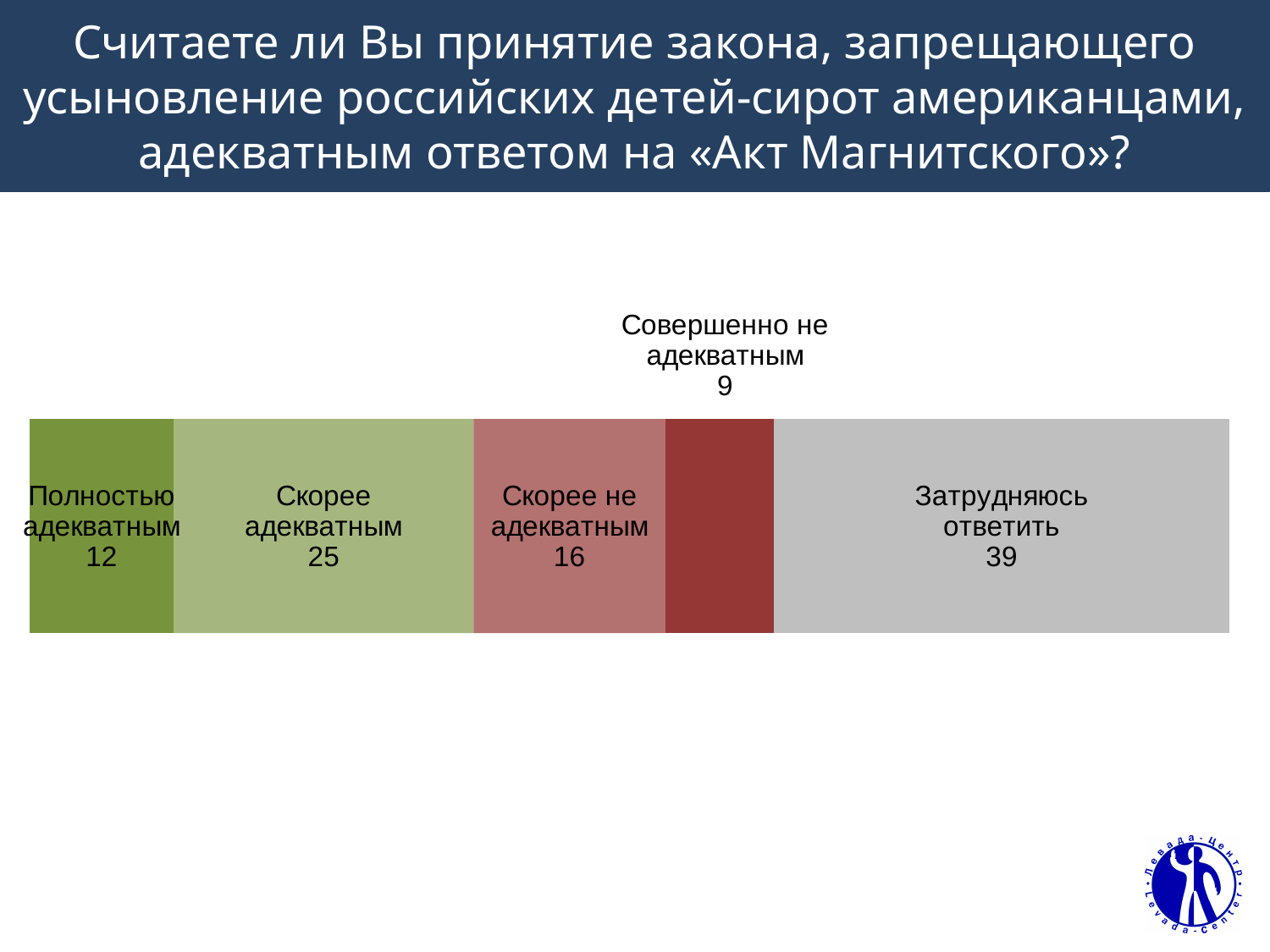
Which category has the lowest value? Совершенно не адекватным What is the total of all segments in the stacked bar? 101 Which is larger, the value for "Полностью адекватным" or the value for "Скорее не адекватным"? Скорее не адекватным What is the value for "Полностью адекватным"? 12 What is the value for "Затрудняюсь ответить"? 39 What is the value for "Скорее адекватным"? 25 What is the difference between the values for "Скорее адекватным" and "Скорее не адекватным"? 9 What colour is the segment for "Затрудняюсь ответить"? Grey How many segments does the stacked bar contain? 5 What is the value for "Совершенно не адекватным"? 9 What kind of chart is shown on the slide? Stacked bar chart Which category has the highest value? Затрудняюсь ответить